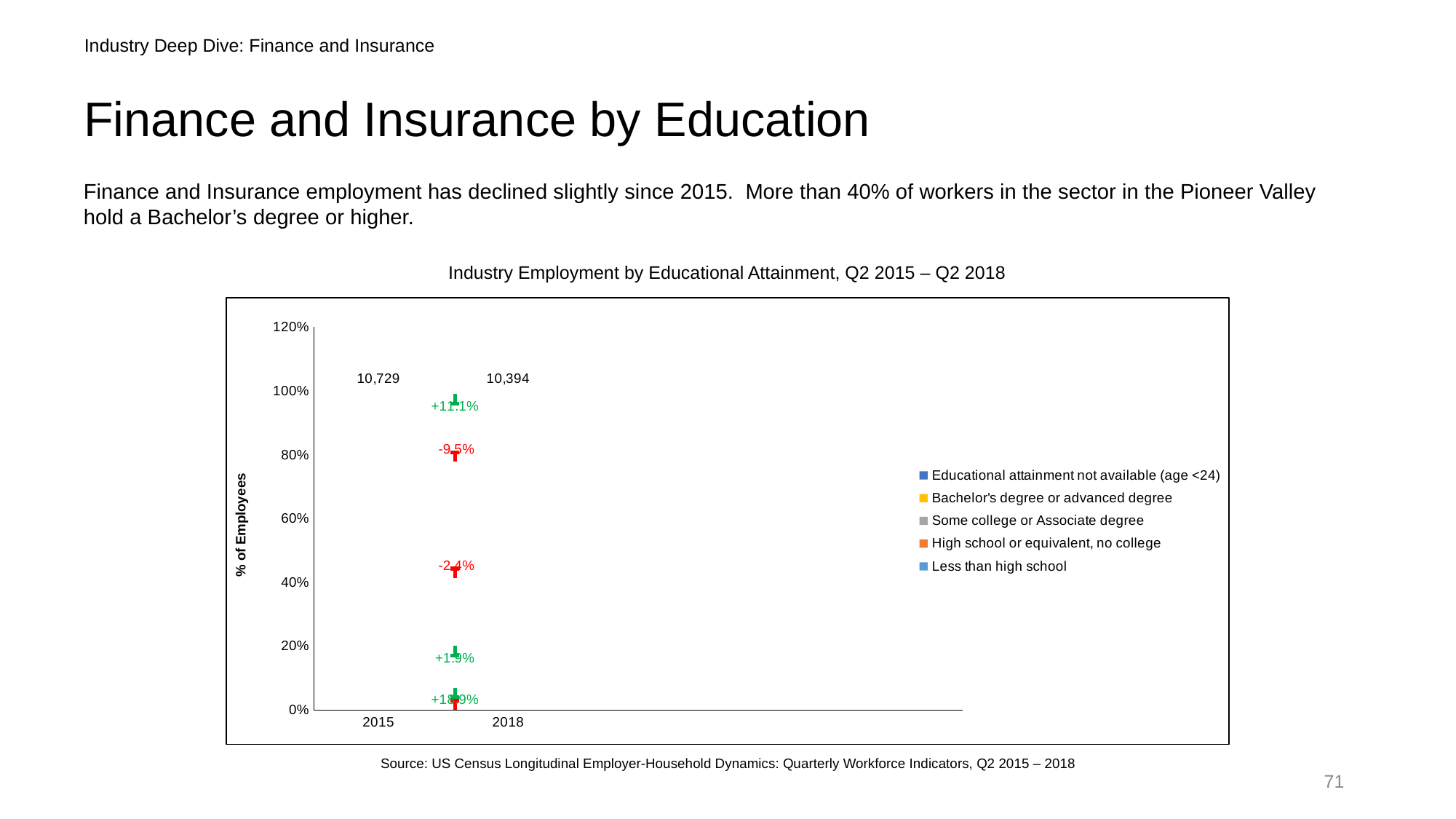
How many series does the chart's legend list? 5 What is the title of the chart? Industry Employment by Educational Attainment, Q2 2015 – Q2 2018 How many years (categories) are shown on the x axis of the chart? 2 What is the label on the chart's y axis? % of Employees What total employment figure is printed above the 2015 bar? 10,729 Does the printed total employment figure fall or rise from 2015 to 2018? fall By how much does the printed total employment figure for 2015 exceed that for 2018? 335 What total employment figure is printed above the 2018 bar? 10,394 Which year has the larger total employment figure printed on the chart, 2015 or 2018? 2015